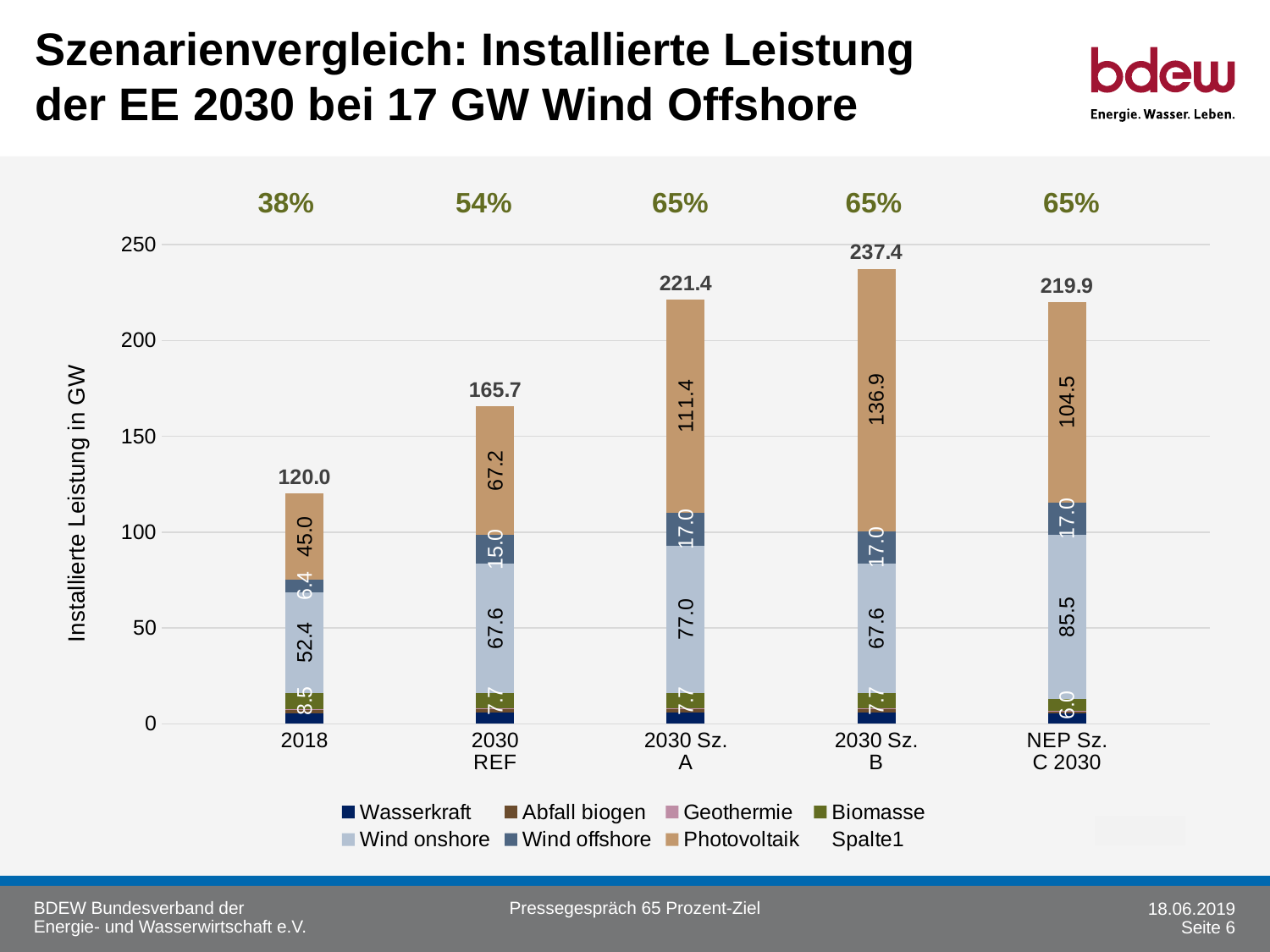
How many entries does the legend list? 8 Which scenario has the highest total installed capacity? 2030 Sz. B What percentage is shown above the 2018 bar? 38% What is the Wind offshore value for 2030 REF? 15.0 What kind of chart is shown on the slide? Stacked bar chart What is the Photovoltaik value for 2030 Sz. B? 136.9 What is the difference between the total for 2030 Sz. B and the total for 2030 Sz. A? 16.0 How many scenarios (bars) are shown on the x axis? 5 What is the Wind onshore value for NEP Sz. C 2030? 85.5 What is the total installed capacity for 2030 REF? 165.7 Which has the larger Photovoltaik value, 2030 Sz. A or NEP Sz. C 2030? 2030 Sz. A Which category has the lowest total installed capacity? 2018